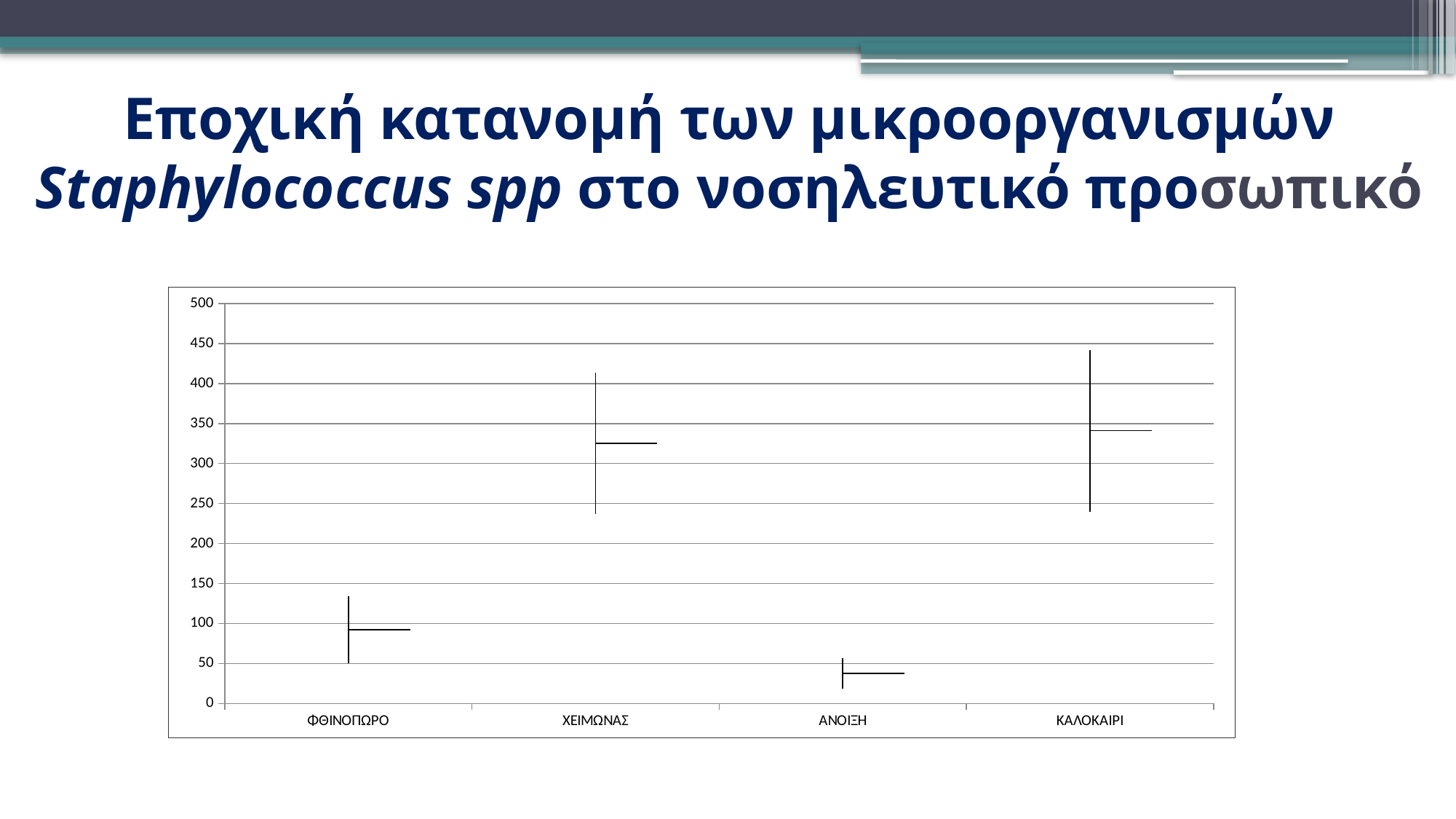
Which category's vertical range reaches the highest point on the chart? ΚΑΛΟΚΑΙΡΙ Which has the larger marker value, ΦΘΙΝΟΠΩΡΟ or ΧΕΙΜΩΝΑΣ? ΧΕΙΜΩΝΑΣ How many categories are shown on the x axis of the chart? 4 What kind of chart is shown on the slide? high-low-close (stock) chart Which has the larger marker value, ΑΝΟΙΞΗ or ΚΑΛΟΚΑΙΡΙ? ΚΑΛΟΚΑΙΡΙ Which category has the lowest marker value in the chart? ΑΝΟΙΞΗ Is the marker value for ΦΘΙΝΟΠΩΡΟ greater or less than 100? less Is the marker value for ΧΕΙΜΩΝΑΣ greater or less than 300? greater What is the first category label on the x axis of the chart? ΦΘΙΝΟΠΩΡΟ Is the marker value for ΑΝΟΙΞΗ greater or less than 50? less What is the maximum value shown on the y axis of the chart? 500